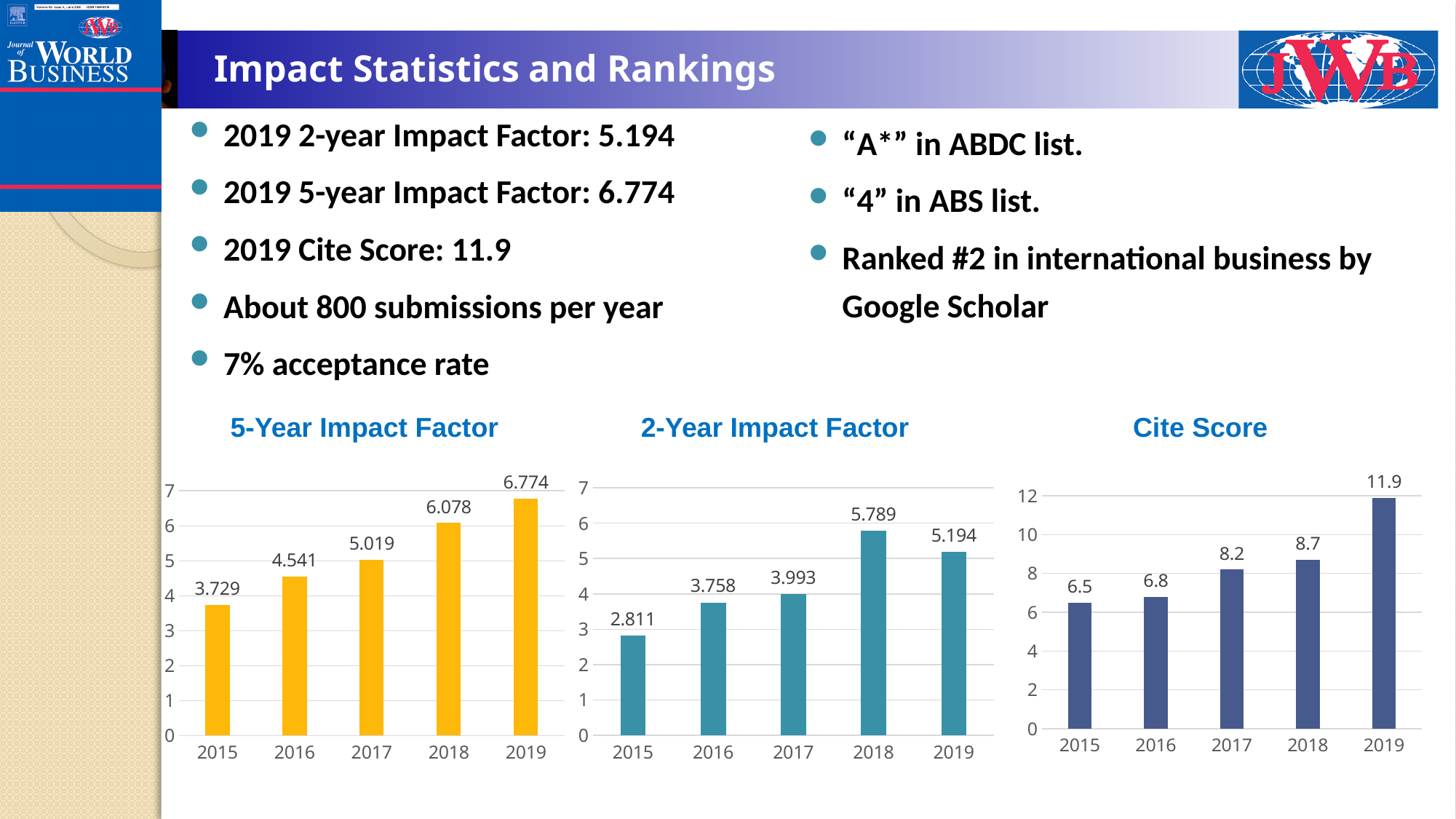
In the 2-Year Impact Factor chart, what is the value for 2015? 2.811 In the 2-Year Impact Factor chart, which is larger, the value for 2018 or the value for 2019? 2018 In the 5-Year Impact Factor chart, what is the value for 2017? 5.019 In the 2-Year Impact Factor chart, which year has the highest value? 2018 In the Cite Score chart, what is the difference between the 2019 and 2018 values? 3.2 In the Cite Score chart, what is the value for 2018? 8.7 In the 5-Year Impact Factor chart, how many years are shown? 5 What colour are the bars in the 5-Year Impact Factor chart? Yellow/orange What kind of chart is the Cite Score chart? Bar chart In the 5-Year Impact Factor chart, do the values rise or fall from 2015 to 2019? Rise In the 5-Year Impact Factor chart, what is the difference between the 2019 and 2015 values? 3.045 In the 5-Year Impact Factor chart, which year has the lowest value? 2015